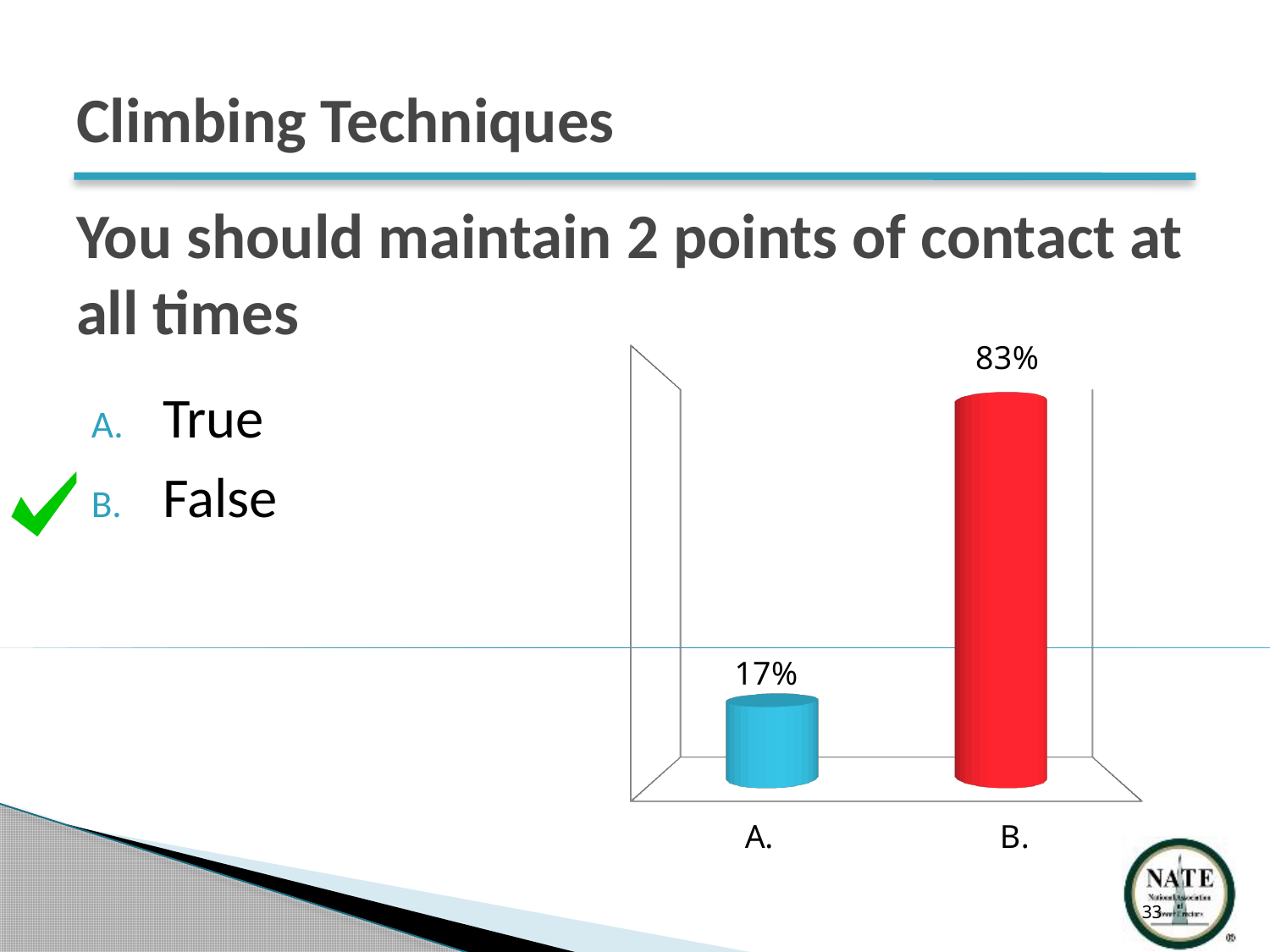
What is the value for category A. in the chart? 17% Which category has the highest value in the chart? B. How many categories are shown in the chart? 2 What colour is the bar for category A.? Blue What is the difference between the values for B. and A.? 66% What kind of chart is shown on the slide? Bar chart What colour is the bar for category B.? Red Which category has the larger value, A. or B.? B. What is the value for category B. in the chart? 83% What is the total of the values for A. and B.? 100% Which category has the lowest value in the chart? A.